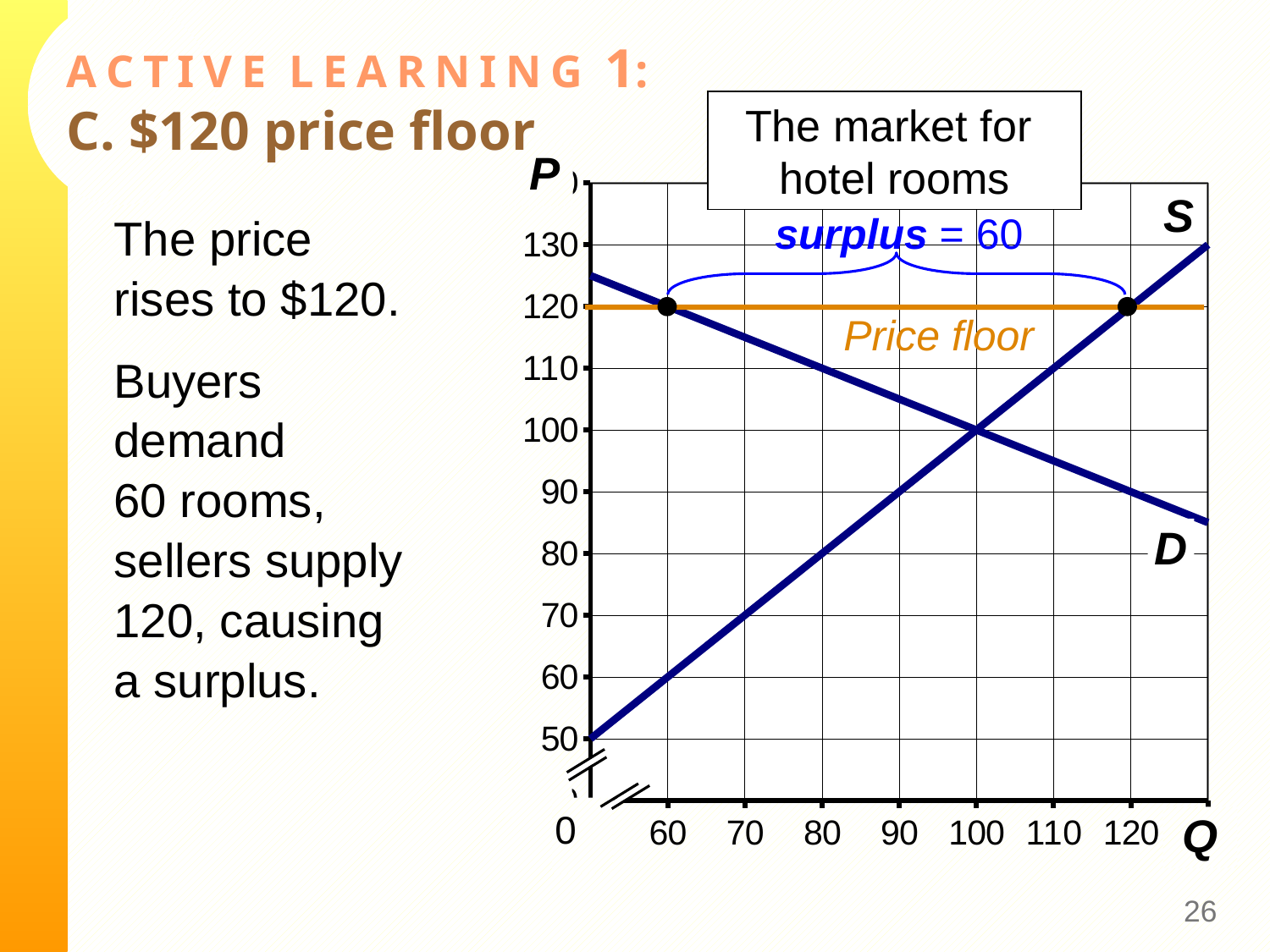
At a quantity of 110, is the price on the demand curve D greater or less than 100? less What quantity is demanded at the price floor of 120? 60 At what quantity do the supply and demand curves intersect? 100 What kind of chart is shown on the slide? line chart Does the demand curve D rise or fall as quantity increases? fall What is the title of the chart? The market for hotel rooms How many curves are plotted on the chart? 2 At a quantity of 120, which curve is higher, S or D? S At what price is the price floor set on the chart? 120 What quantity is supplied at the price floor of 120? 120 What is the difference between quantity supplied and quantity demanded at the price floor? 60 What is the size of the surplus shown on the chart? 60